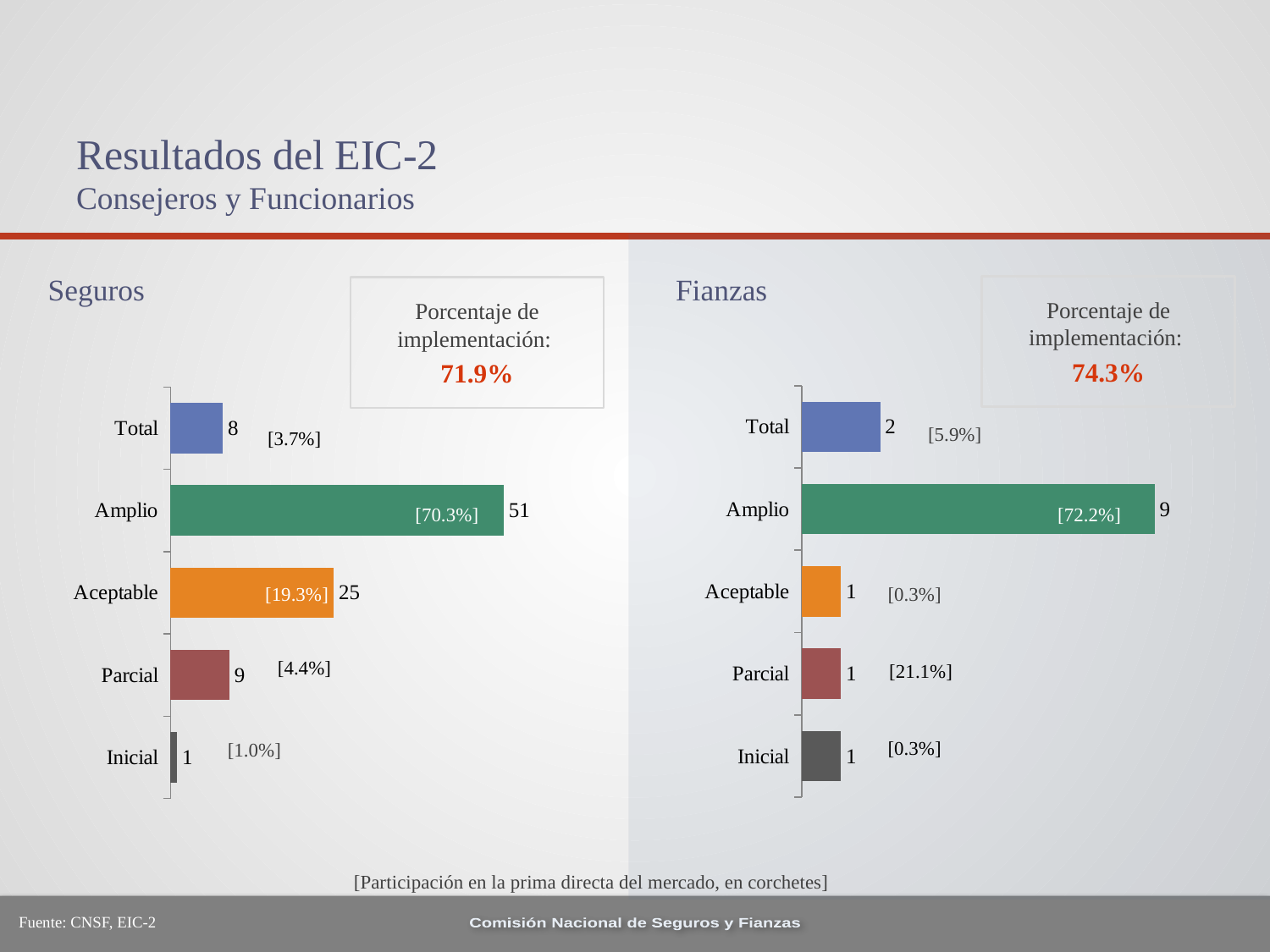
In the Seguros chart, which is larger, the value for Parcial or the value for Total? Parcial In the Fianzas chart, which category has the highest value? Amplio What kind of chart is the Seguros chart? bar chart In the Fianzas chart, what is the value for Amplio? 9 How many categories does the Fianzas chart show? 5 What is the Porcentaje de implementación shown for Fianzas? 74.3% In the Seguros chart, what is the difference between the values for Amplio and Aceptable? 26 In the Fianzas chart, what is the value for Total? 2 In the Seguros chart, what is the value for Aceptable? 25 In the Seguros chart, which category has the highest value? Amplio In the Seguros chart, which category has the lowest value? Inicial In the Seguros chart, what is the value for Amplio? 51